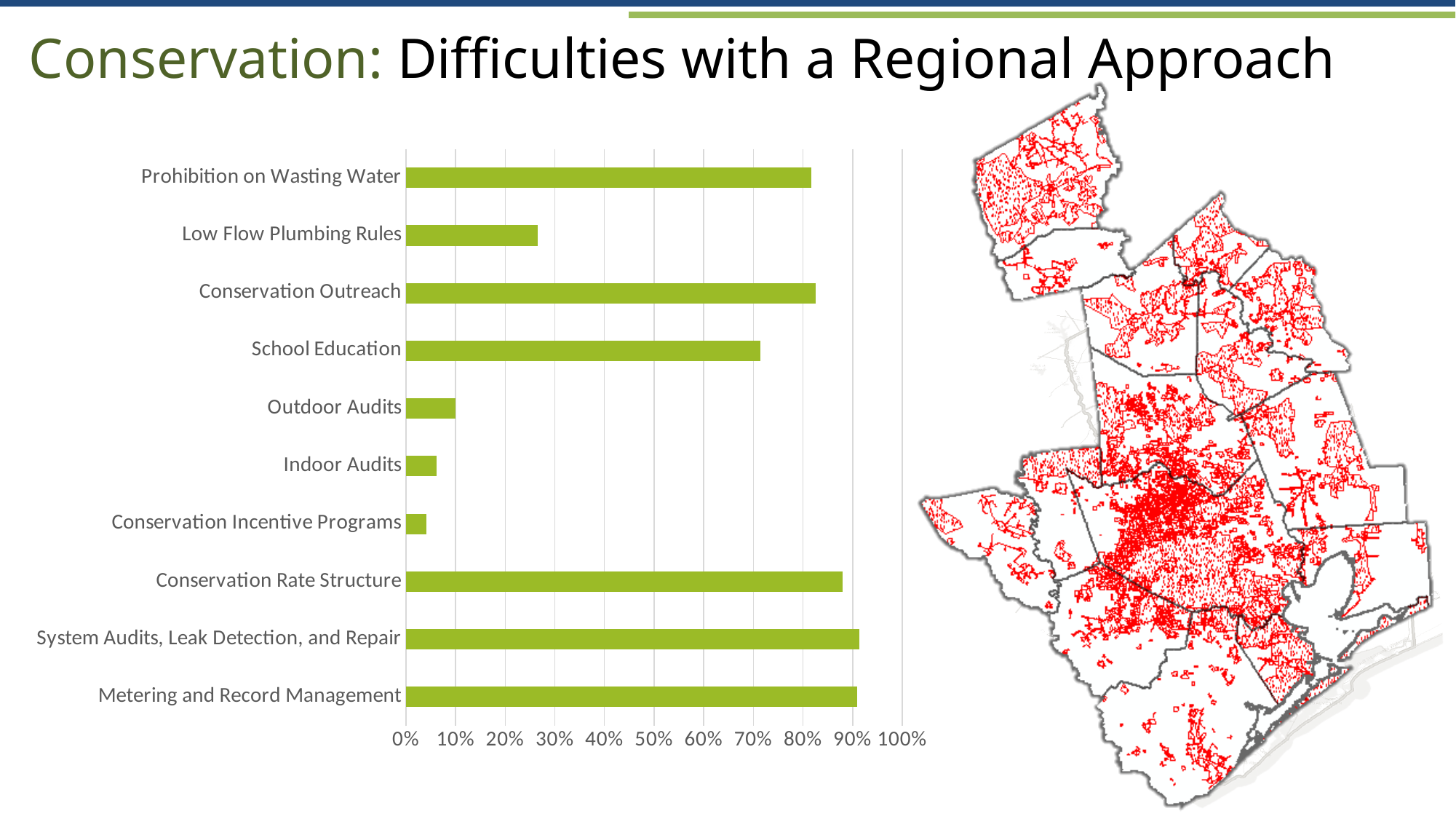
What kind of chart is shown on the slide? bar chart Is the value for Conservation Incentive Programs greater or less than 10%? less What is the highest value shown on the horizontal axis of the bar chart? 100% Which is larger, the value for Conservation Rate Structure or the value for Conservation Outreach? Conservation Rate Structure Which is larger, the value for Low Flow Plumbing Rules or the value for School Education? School Education Which is larger, the value for Outdoor Audits or the value for Indoor Audits? Outdoor Audits Is the value for Conservation Rate Structure greater or less than 80%? greater Is the value for Low Flow Plumbing Rules greater or less than 30%? less How many categories are plotted in the bar chart? 10